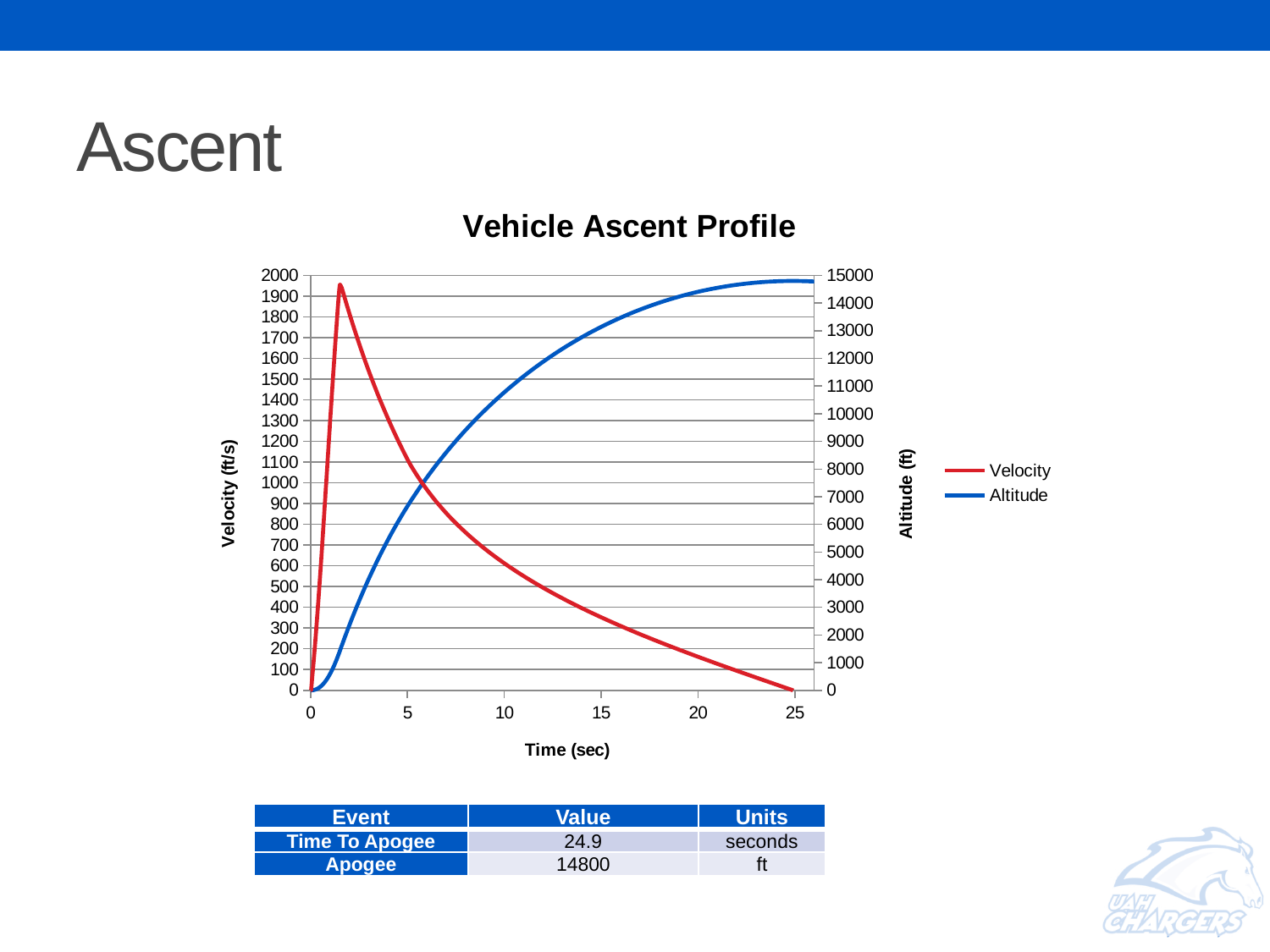
In the Vehicle Ascent Profile chart, does the Altitude series rise or fall as time increases? rise In the Vehicle Ascent Profile chart, is the Altitude at 2 seconds greater or less than 3000 ft? less In the Vehicle Ascent Profile chart, is the peak Velocity greater or less than 1500 ft/s? greater In the Vehicle Ascent Profile chart, is the Altitude at 20 seconds greater or less than 14000 ft? greater Which series in the Vehicle Ascent Profile chart is drawn in blue? Altitude In the Vehicle Ascent Profile chart, does the Velocity series rise or fall between 5 and 25 seconds? fall What is the title of the chart on the slide? Vehicle Ascent Profile What kind of chart is the Vehicle Ascent Profile? line chart How many series does the legend of the Vehicle Ascent Profile chart list? 2